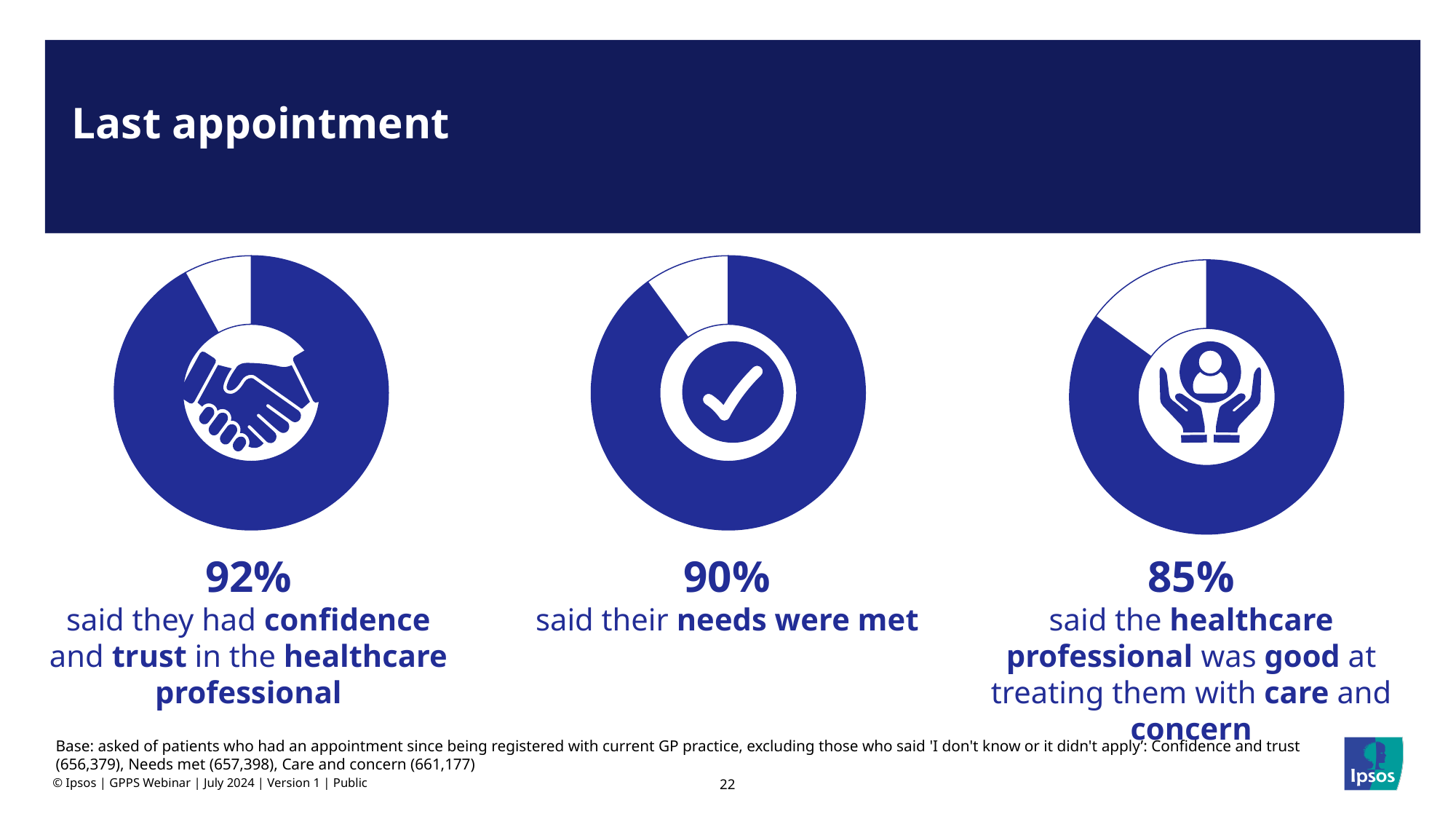
What is the title of the slide? Last appointment What percentage of patients said their needs were met? 90% What is the difference in percentage points between the confidence and trust figure and the care and concern figure? 7 Which of the three measures on the slide has the lowest percentage? Healthcare professional was good at treating them with care and concern How many pie charts are shown on the slide? 3 What kind of chart is used to show each percentage on the slide? Doughnut chart What percentage of patients said they had confidence and trust in the healthcare professional? 92% Which of the three measures on the slide has the highest percentage? Confidence and trust in the healthcare professional What percentage of patients said the healthcare professional was good at treating them with care and concern? 85% What is the difference in percentage points between the needs were met figure and the care and concern figure? 5 Which is larger: the percentage who said their needs were met or the percentage who said the healthcare professional was good at treating them with care and concern? Needs were met What is the base size for the Needs met measure shown in the footnote? 657,398